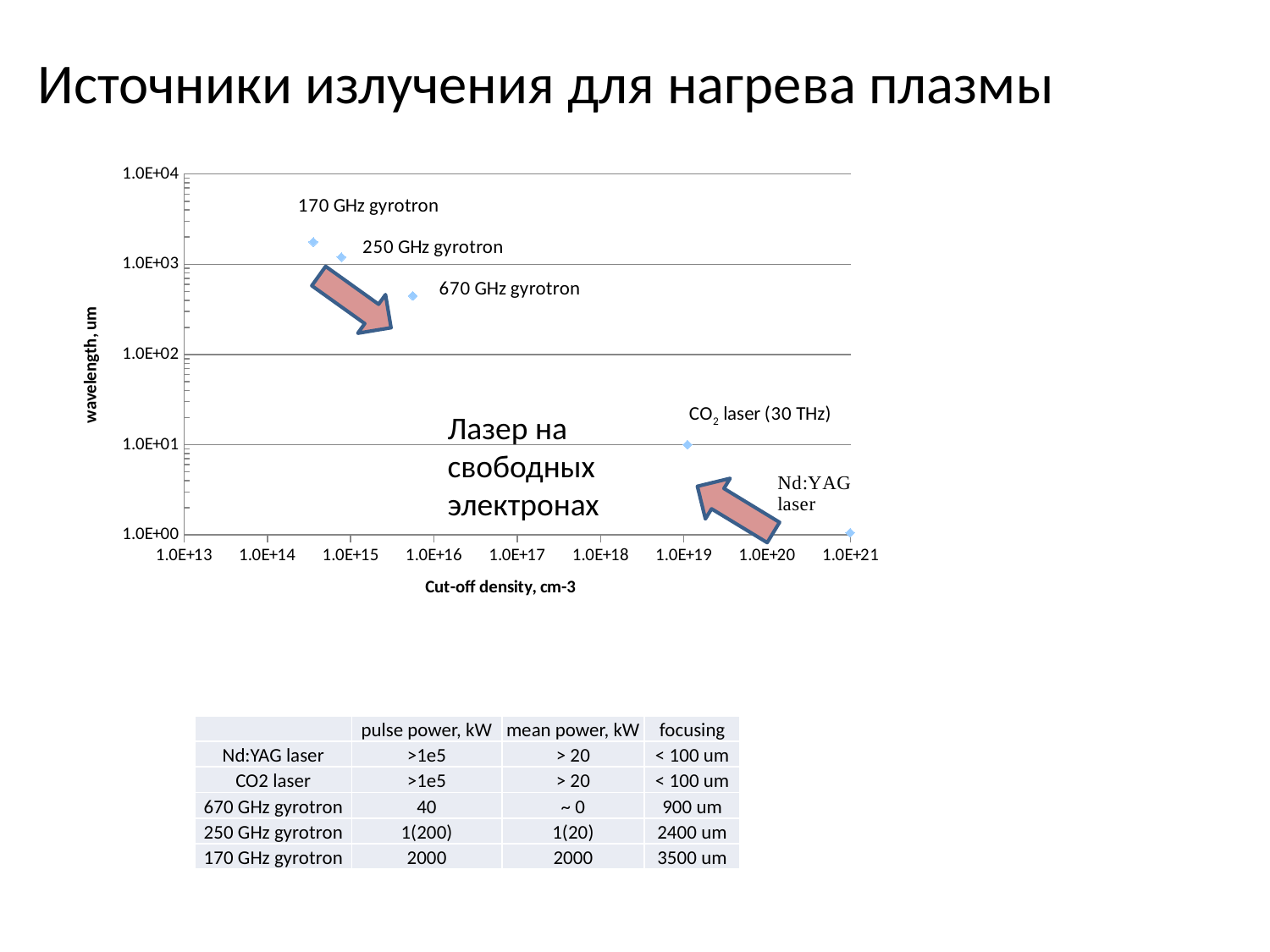
Which radiation source has the highest cut-off density on the chart? Nd:YAG laser How many data points are plotted on the chart? 5 Which radiation source has the lowest wavelength on the chart? Nd:YAG laser Is the wavelength for the 670 GHz gyrotron greater or less than 1.0E+03 um? less Is the cut-off density for the CO2 laser greater or less than 1.0E+17 cm-3? greater Which radiation source has the highest wavelength on the chart? 170 GHz gyrotron Which has the larger wavelength, the 250 GHz gyrotron or the 670 GHz gyrotron? 250 GHz gyrotron Which radiation source has the lowest cut-off density on the chart? 170 GHz gyrotron What kind of chart is shown on the slide? scatter chart Is the wavelength for the 170 GHz gyrotron greater or less than 1.0E+03 um? greater As cut-off density increases along the x axis, does the wavelength rise or fall? fall What is the title of the x axis of the chart? Cut-off density, cm-3